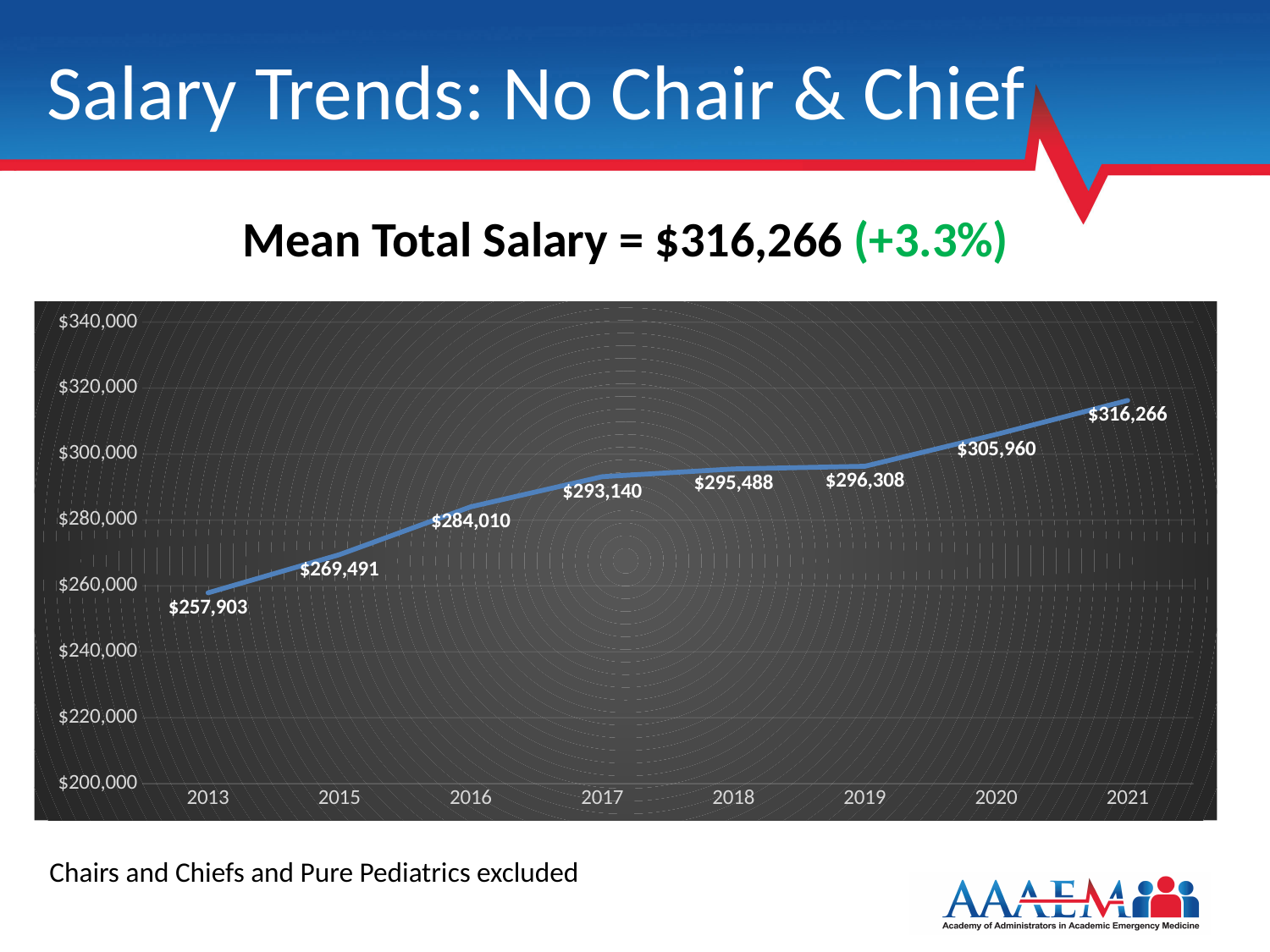
How many years are plotted on the chart? 8 What is the difference between the 2021 and 2020 mean total salaries? $10,306 What is the mean total salary shown for 2021? $316,266 Which year has the lowest mean total salary on the chart? 2013 What is the mean total salary shown for 2013? $257,903 Which year has the highest mean total salary on the chart? 2021 Which is larger, the mean total salary for 2016 or for 2015? 2016 Do the mean total salary values rise or fall from 2013 to 2021? rise What is the difference between the 2019 and 2018 mean total salaries? $820 What kind of chart is shown on the slide? line chart Is the mean total salary for 2020 greater or less than $300,000? greater What is the mean total salary shown for 2017? $293,140